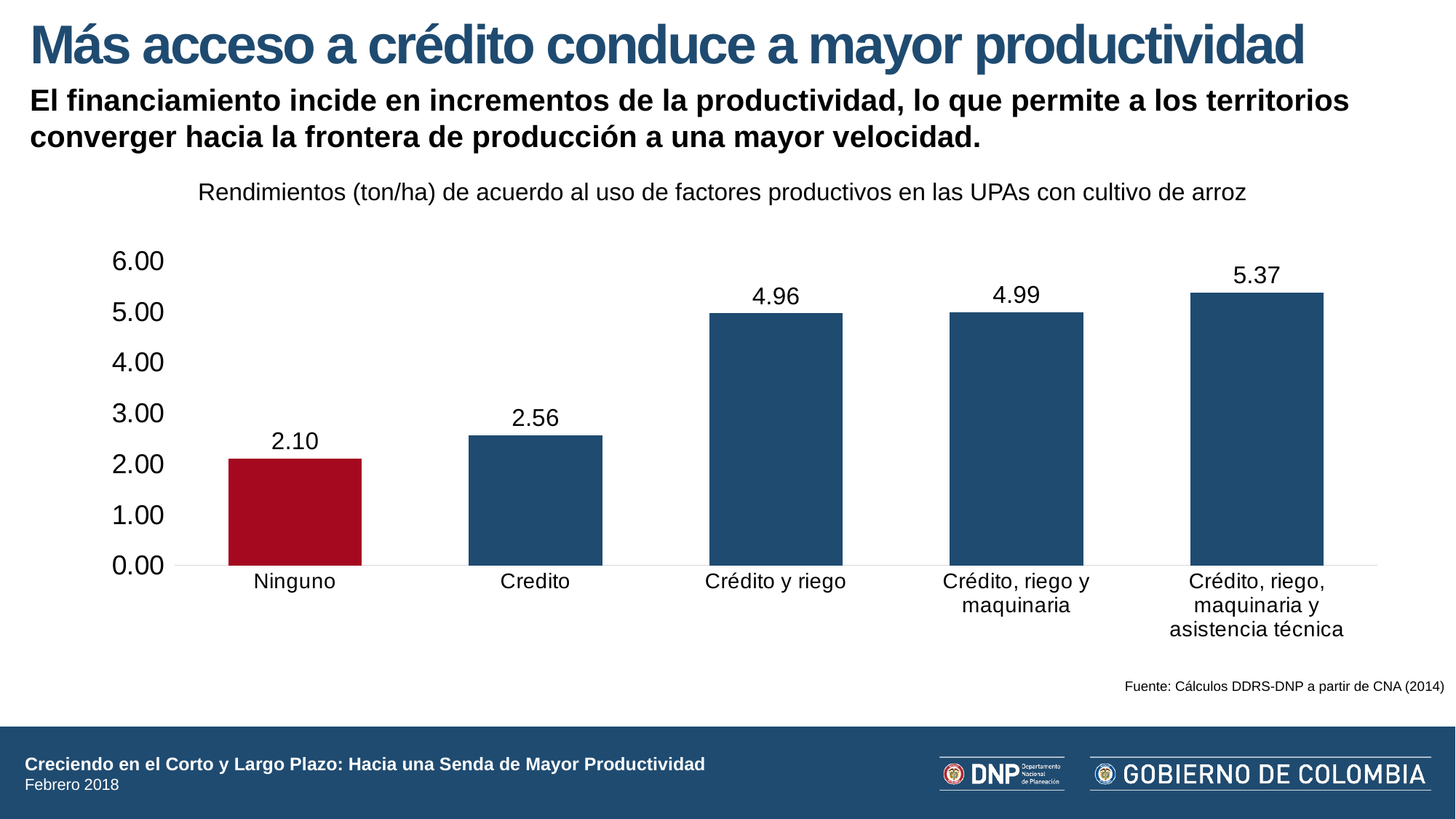
What is the value for Ninguno? 2.10 What is the value for Credito? 2.56 What is the value for Crédito y riego? 4.96 Is the value for Crédito, riego y maquinaria greater or less than 4.00? greater What is the difference between the values for Crédito, riego, maquinaria y asistencia técnica and Ninguno? 3.27 Which is larger, the value for Credito or the value for Crédito y riego? Crédito y riego Do the values rise or fall from left to right along the x axis? rise What is the value for Crédito, riego, maquinaria y asistencia técnica? 5.37 How many categories are shown on the x axis? 5 What kind of chart is shown on the slide? bar chart Which category has the lowest value? Ninguno Which category has the highest value? Crédito, riego, maquinaria y asistencia técnica